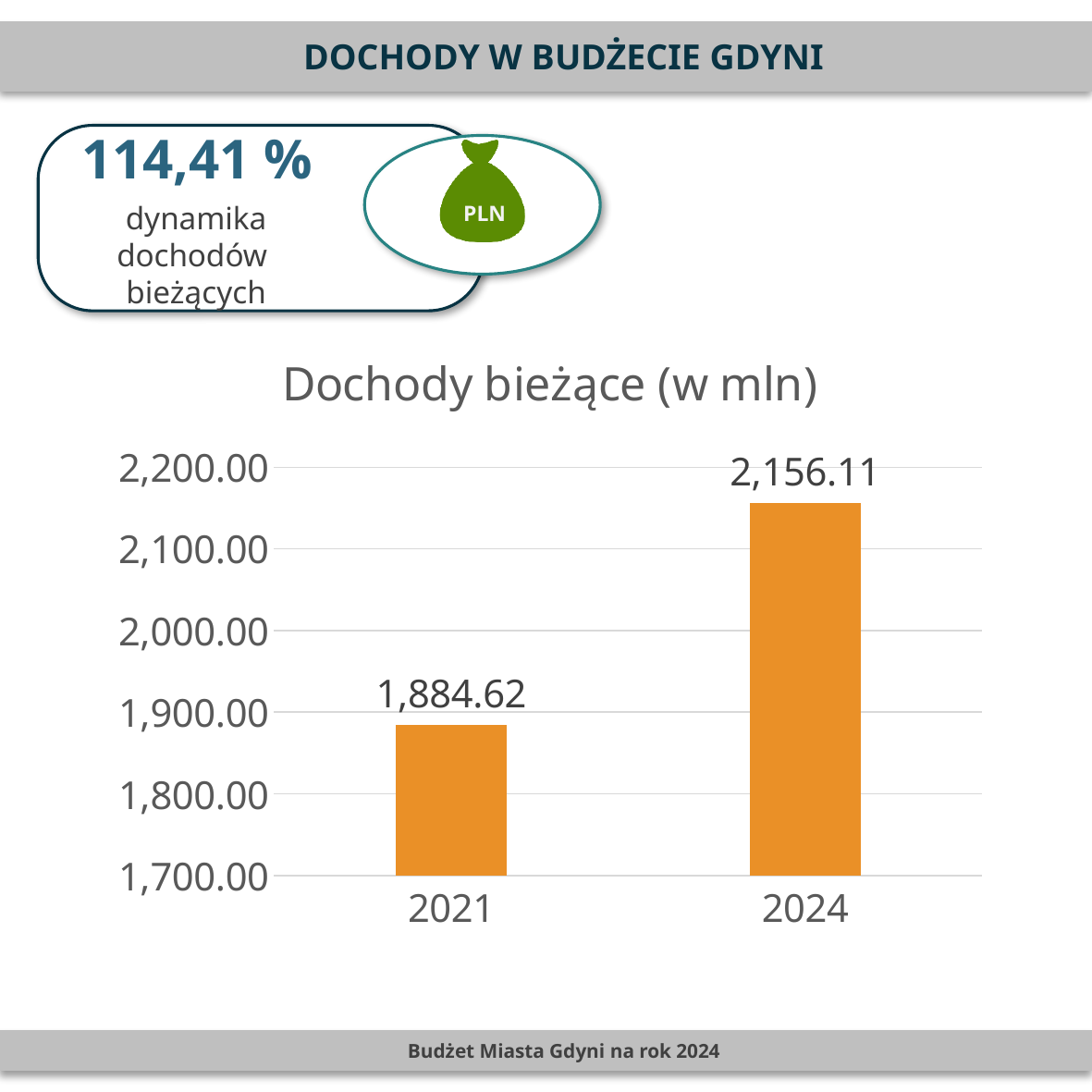
What is the value for 2021 in the chart? 1,884.62 What is the value for 2024 in the chart? 2,156.11 What is the difference between the values for 2024 and 2021? 271.49 What kind of chart is shown on the slide? bar chart Do the values rise or fall from 2021 to 2024? rise Is the value for 2024 greater or less than 2,100.00? greater Which is larger, the value for 2021 or the value for 2024? 2024 What is the title of the chart? Dochody bieżące (w mln) Is the value for 2021 greater or less than 1,900.00? less How many bars are shown in the chart? 2 Which year has the lowest value in the chart? 2021 Which year has the highest value in the chart? 2024